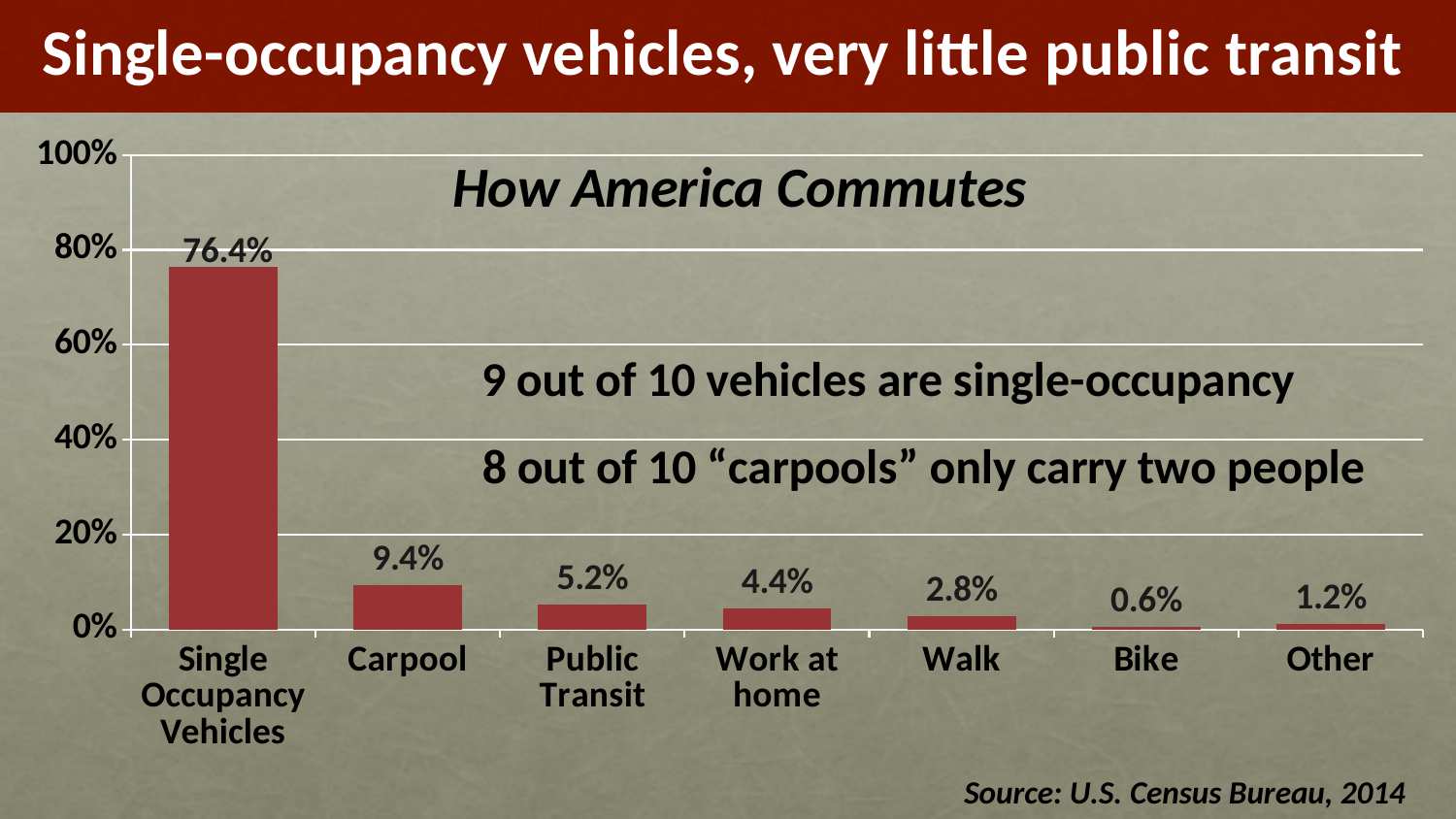
Which category has the lowest value? Bike Which is larger, the value for Work at home or the value for Walk? Work at home Is the value for Single Occupancy Vehicles greater or less than 60%? greater What is the value for Carpool? 9.4% What is the value for Single Occupancy Vehicles? 76.4% Which category has the highest value? Single Occupancy Vehicles What is the value for Walk? 2.8% What is the value for Public Transit? 5.2% What is the title of the chart? How America Commutes How many categories are shown on the x axis? 7 What kind of chart is shown on the slide? bar chart What is the difference between the values for Carpool and Public Transit? 4.2%